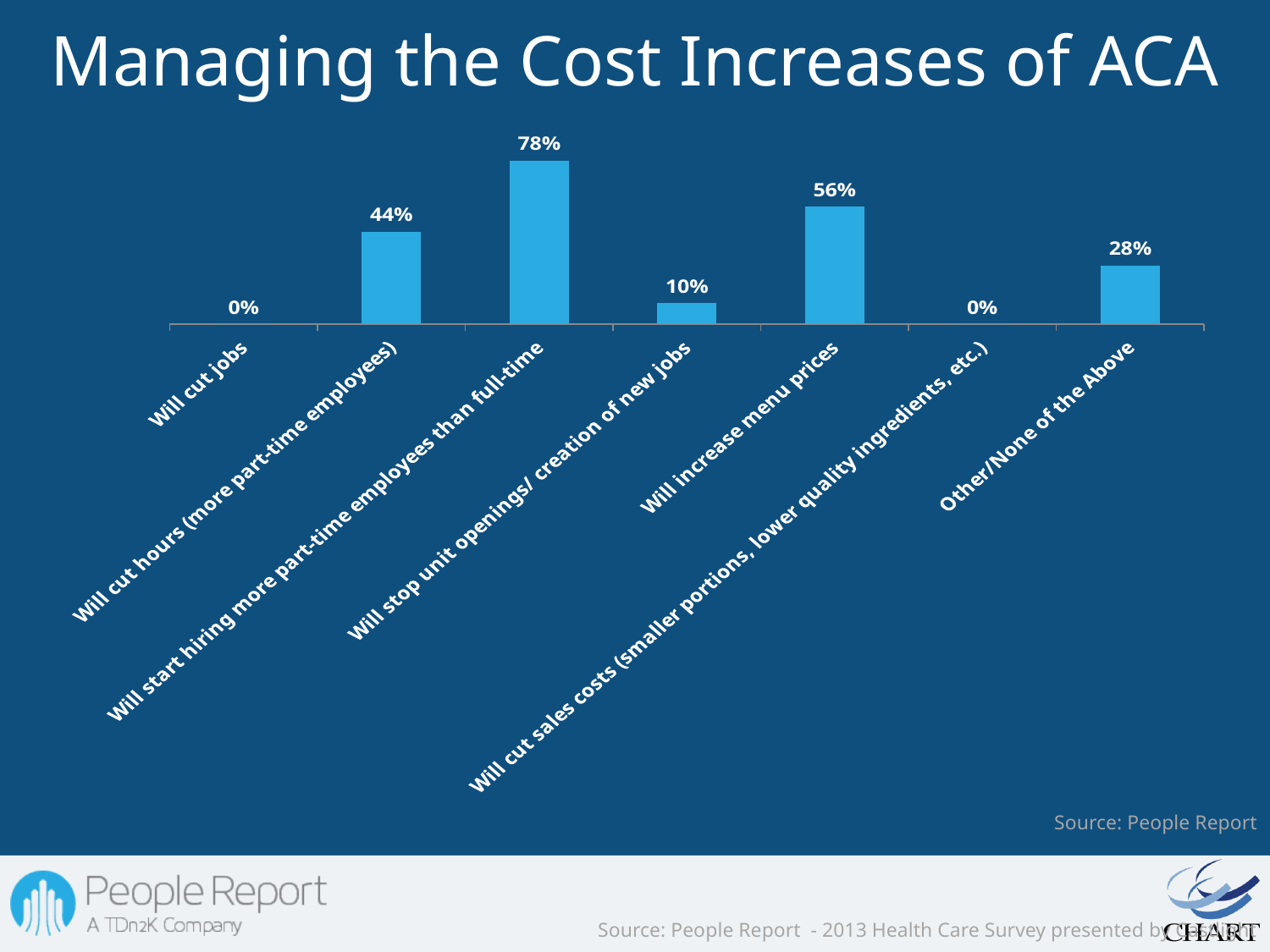
What is the difference between "Will start hiring more part-time employees than full-time" and "Will increase menu prices"? 22% What is the value for "Will increase menu prices"? 56% What kind of chart is shown on the slide? Bar chart What is the value for "Other/None of the Above"? 28% What is the value for "Will cut hours (more part-time employees)"? 44% How many categories are shown on the chart? 7 Which is larger: "Will increase menu prices" or "Will cut hours (more part-time employees)"? Will increase menu prices What is the value for "Will stop unit openings/ creation of new jobs"? 10% Which category has the highest value? Will start hiring more part-time employees than full-time How many categories have a value of 0%? 2 What is the title of the chart? Managing the Cost Increases of ACA What is the difference between "Will cut hours (more part-time employees)" and "Other/None of the Above"? 16%